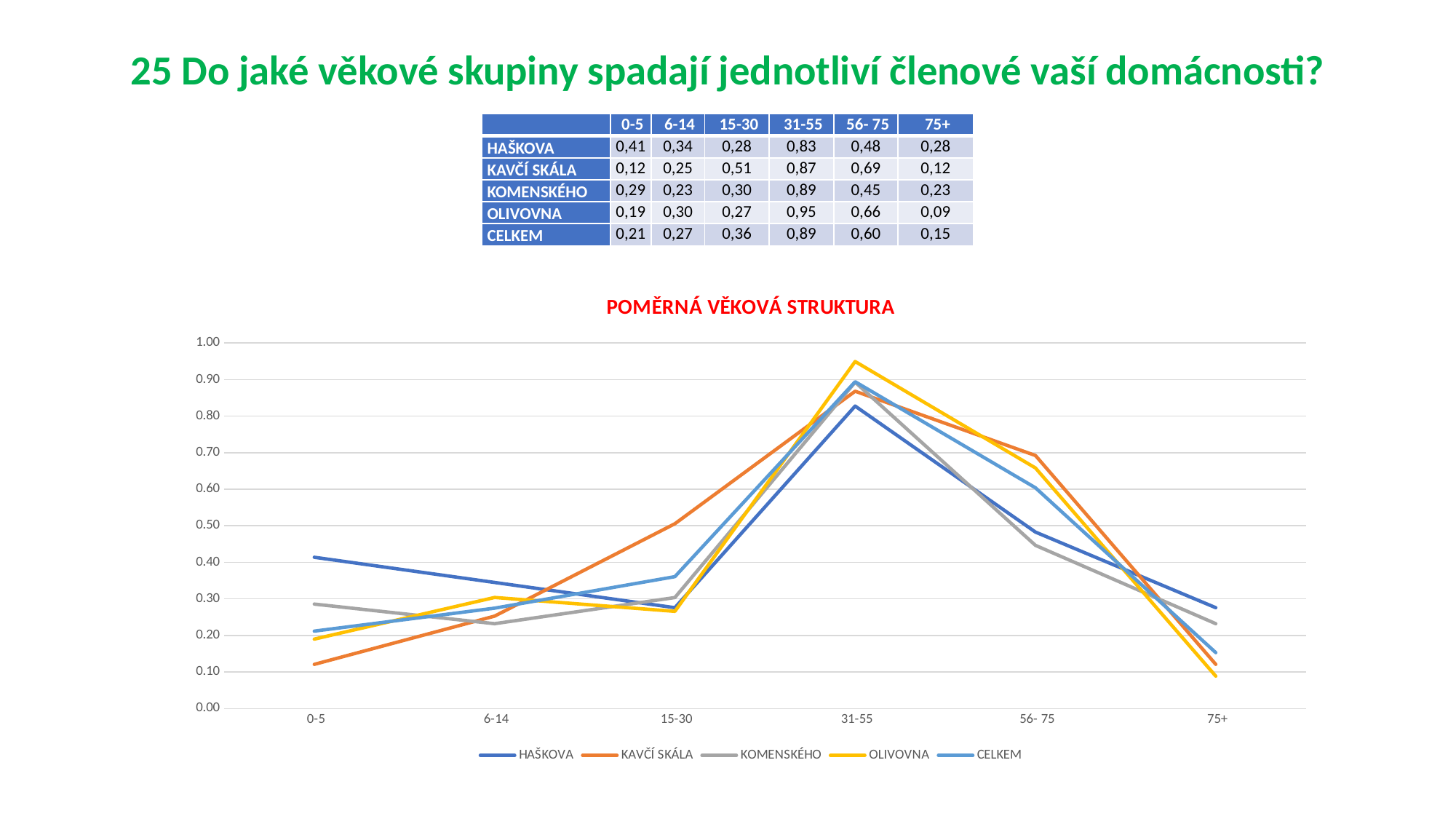
Does the CELKEM line rise or fall from the 31-55 age group to the 75+ age group? fall Is the value for KAVČÍ SKÁLA in the 56- 75 age group greater or less than 0.60? greater What kind of chart is shown under the title POMĚRNÁ VĚKOVÁ STRUKTURA? line chart In which age group does the OLIVOVNA series have its lowest value? 75+ Which series has the highest value in the 0-5 age group? HAŠKOVA What is the difference between the OLIVOVNA and HAŠKOVA values in the 31-55 age group? 0,12 What is the value for HAŠKOVA in the 0-5 age group? 0,41 In which age group does the CELKEM series reach its highest value? 31-55 How many age-group categories are shown on the x axis of the chart? 6 How many series does the legend of the chart list? 5 What is the value for OLIVOVNA in the 31-55 age group? 0,95 In the 15-30 age group, which is larger: KAVČÍ SKÁLA or HAŠKOVA? KAVČÍ SKÁLA